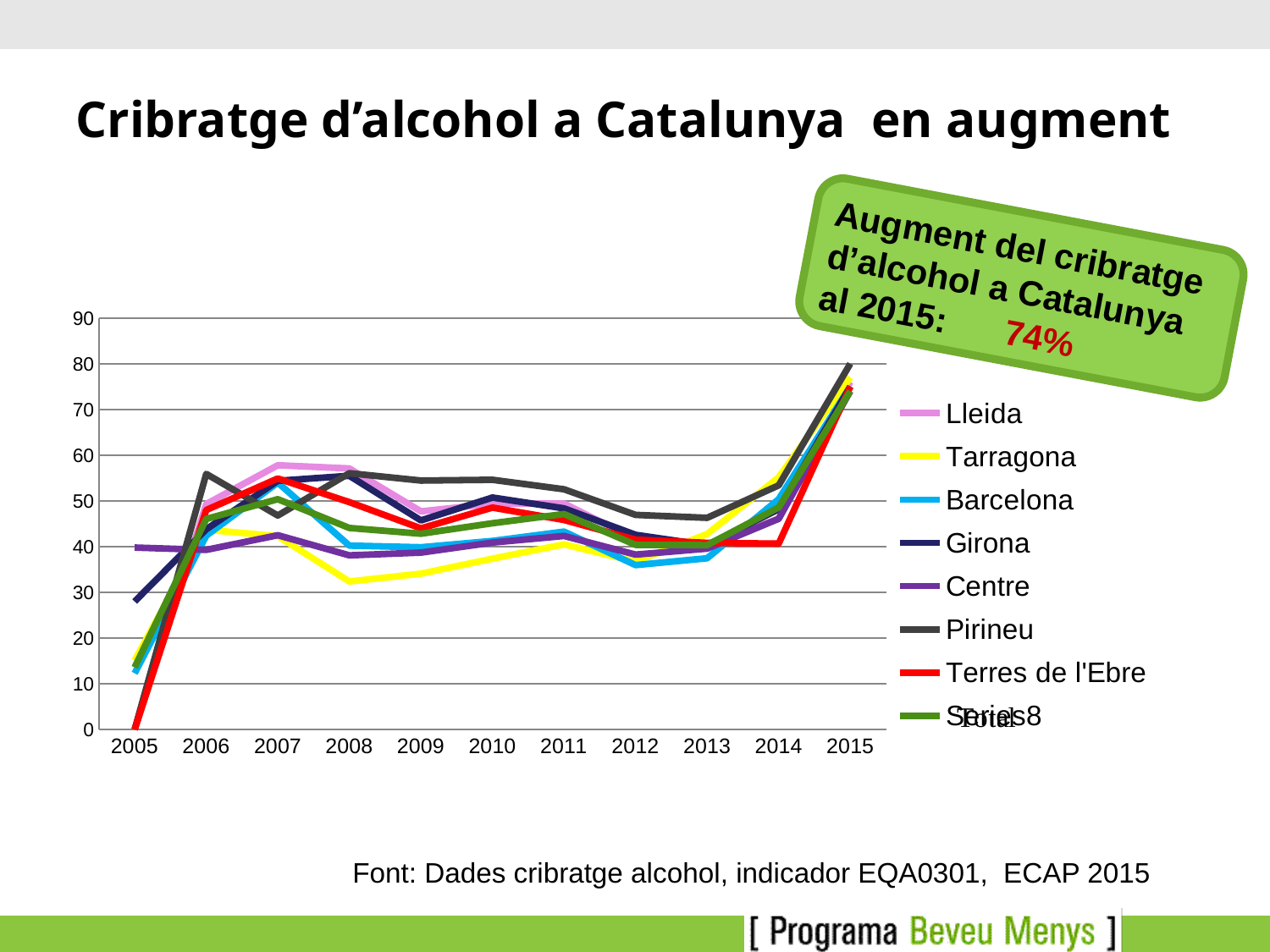
Is the value for Barcelona in 2005 greater or less than 20? less Which series has the lowest value in 2008? Tarragona What colour is the Tarragona line in the chart? yellow Is the value for Tarragona in 2008 greater or less than 40? less What is the last year shown on the x axis of the chart? 2015 What is the first year shown on the x axis of the chart? 2005 How many years are plotted along the x axis of the chart? 11 In 2008, which is larger, the value for Pirineu or the value for Tarragona? Pirineu What kind of chart is shown on the slide? line chart Overall, do the values rise or fall from 2005 to 2015? rise Is the value for Pirineu in 2015 greater or less than 70? greater